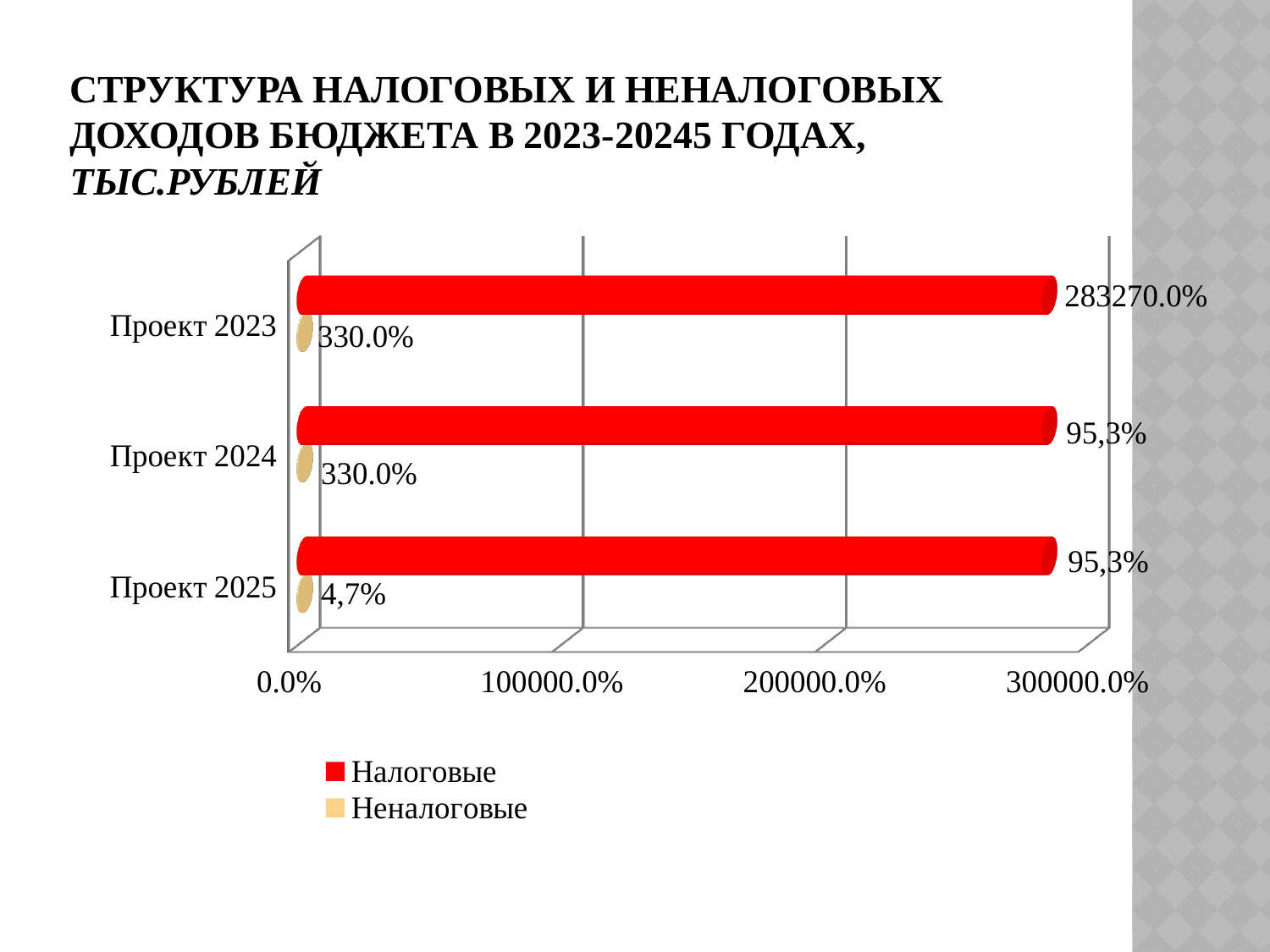
How many categories are shown on the vertical axis? 3 How many series does the legend list? 2 For Проект 2025, which series has the longer bar, Налоговые or Неналоговые? Налоговые Which series is shown in red in the legend? Налоговые What kind of chart is shown on the slide? bar chart What is the data label on the Неналоговые bar for Проект 2024? 330.0% What is the data label on the Неналоговые bar for Проект 2025? 4,7% What is the data label on the Налоговые bar for Проект 2023? 283270.0% What is the data label on the Неналоговые bar for Проект 2023? 330.0% Is the Налоговые bar for Проект 2024 greater or less than 200000.0% on the horizontal axis? greater What is the data label on the Налоговые bar for Проект 2024? 95,3% What is the data label on the Налоговые bar for Проект 2025? 95,3%